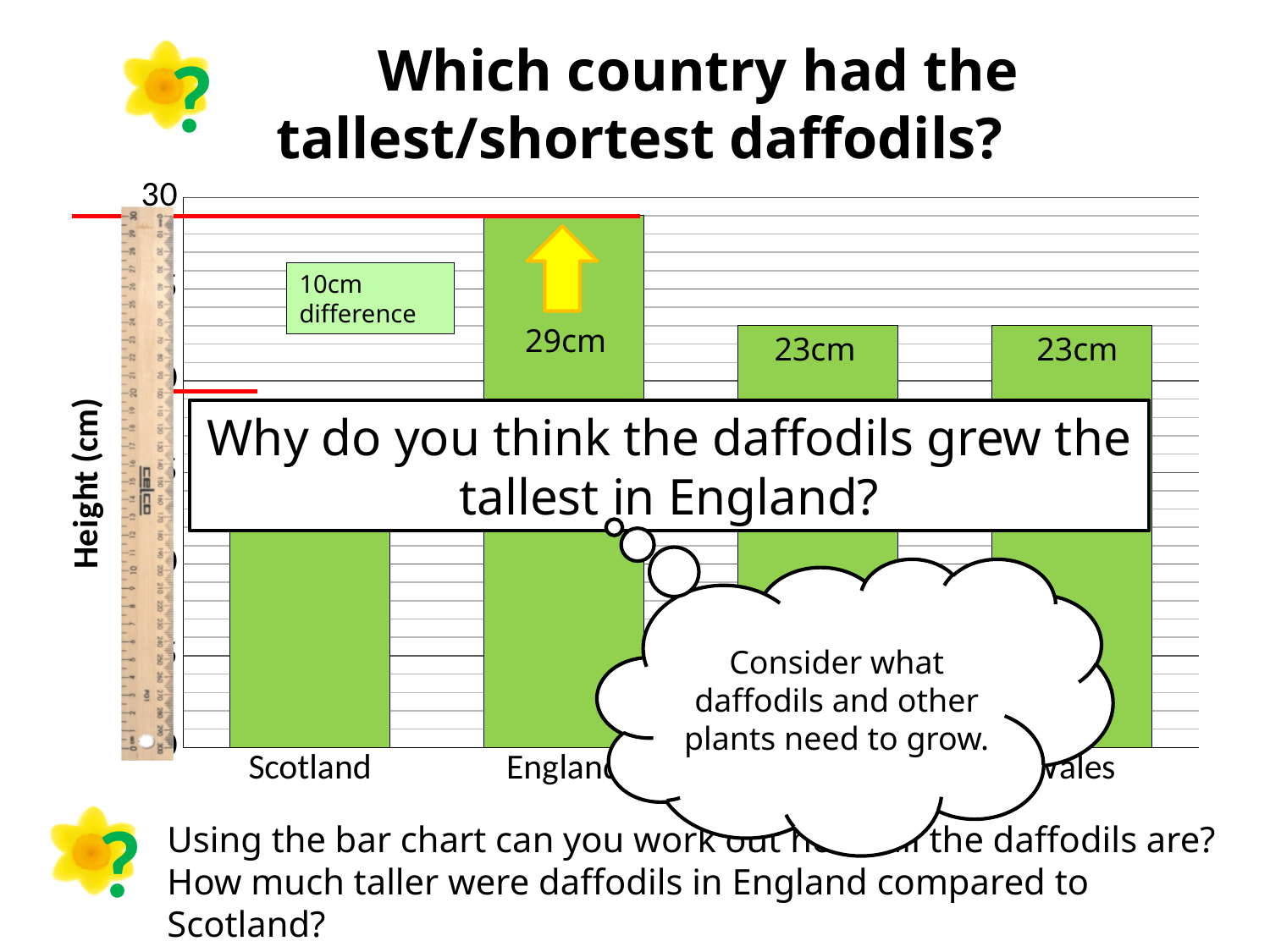
Which is larger, the daffodil height for England or for Wales? England What is the height of the daffodils in Wales? 23cm What is the height of the daffodils in England? 29cm Which country had the shortest daffodils? Scotland What kind of chart is shown on the slide? bar chart Which is larger, the daffodil height for Scotland or for England? England According to the annotation on the chart, how much taller were the daffodils in England than in Scotland? 10cm Which country had the tallest daffodils? England How many bars are plotted in the chart? 4 What is the label on the vertical axis of the chart? Height (cm) What colour are the bars in the chart? green Is the value for Scotland greater or less than 30? less